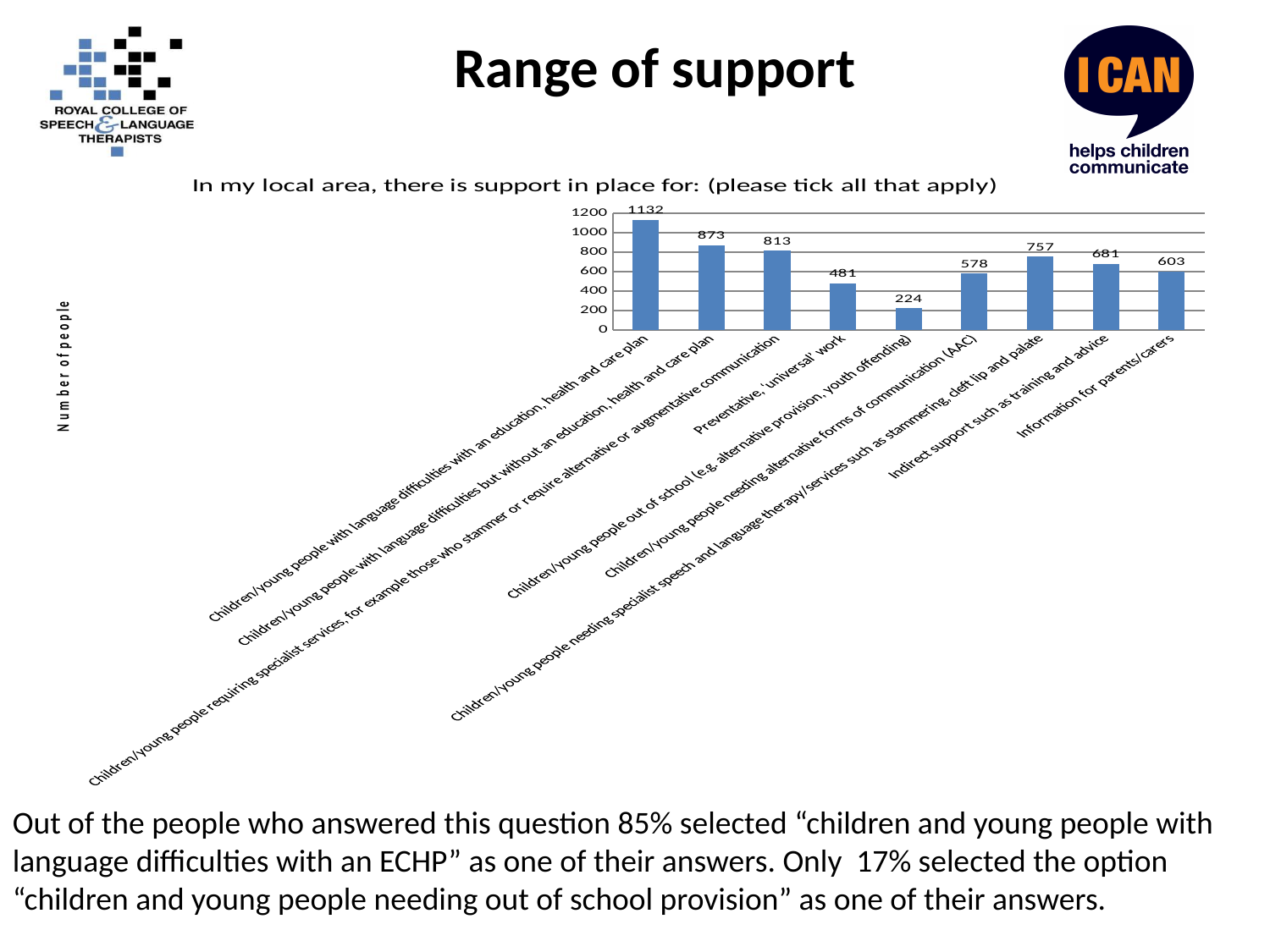
What is the difference between the highest value (1132) and the lowest value (224)? 908 What is the label of the vertical axis? Number of people Which category has the lowest value? Children/young people out of school (e.g. alternative provision, youth offending) Which is larger: the value for 'Indirect support such as training and advice' or the value for 'Information for parents/carers'? Indirect support such as training and advice What is the value for 'Preventative, ‘universal’ work'? 481 What is the value for 'Information for parents/carers'? 603 What type of chart is shown on the slide? Bar chart What is the value for 'Indirect support such as training and advice'? 681 What is the value for 'Children/young people needing alternative forms of communication (AAC)'? 578 Which category has the highest value? Children/young people with language difficulties with an education, health and care plan How many categories are plotted in the chart? 9 What is the title of the chart? In my local area, there is support in place for: (please tick all that apply)